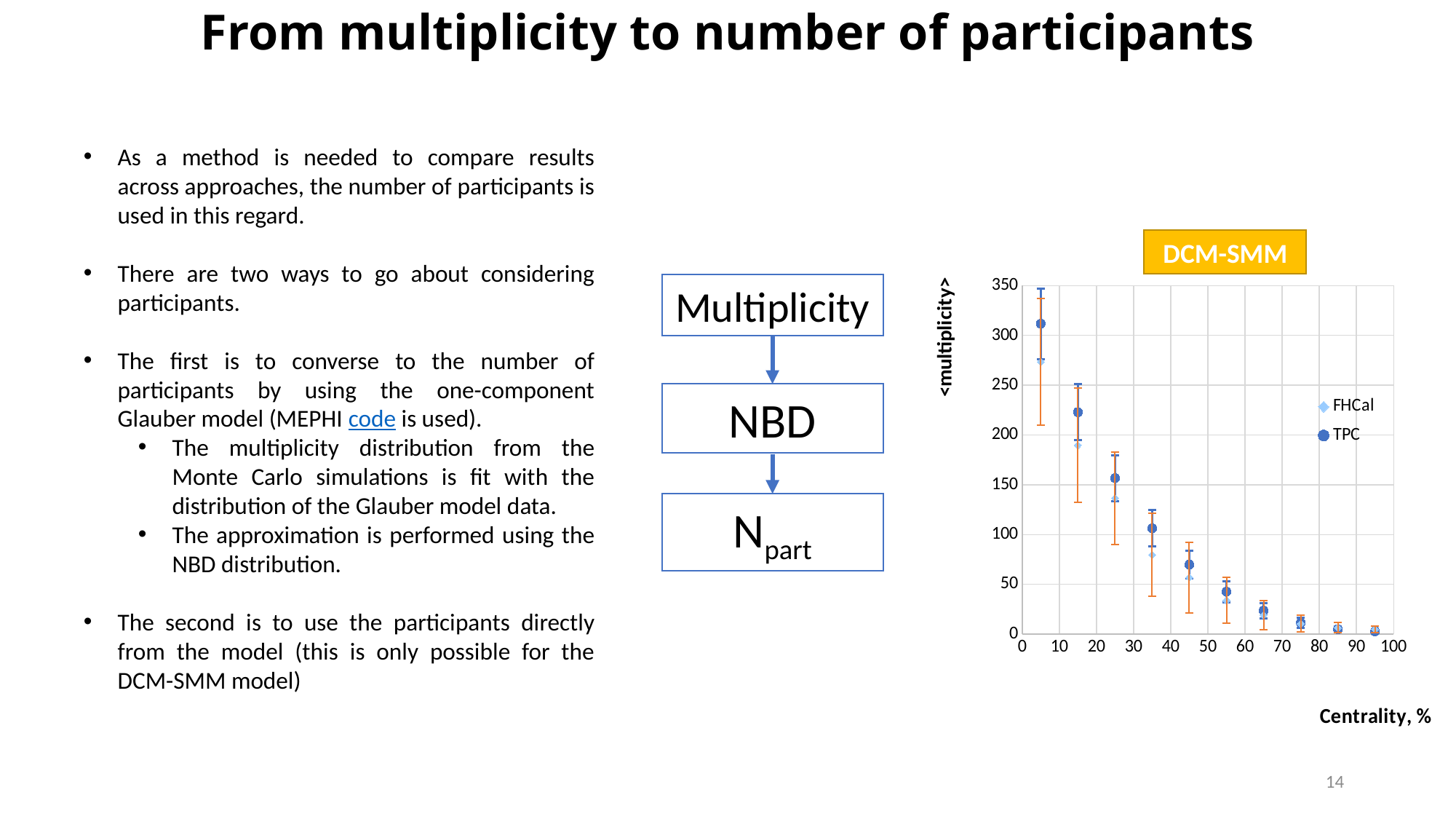
What is the label of the x axis of the chart? Centrality, % What are the two series named in the chart legend? FHCal and TPC How many series does the chart legend list? 2 Which is larger for the TPC series: the value at centrality 25% or at centrality 45%? 25% How many data points are plotted for the TPC series? 10 Is the TPC value at centrality 35% greater or less than 150? less Which centrality bin has the highest TPC multiplicity? 5 Is the TPC value at centrality 15% greater or less than 200? greater Do the multiplicity values rise or fall as centrality increases along the x axis? fall What kind of chart is shown on the slide? scatter chart Is the TPC value at centrality 55% greater or less than 50? less